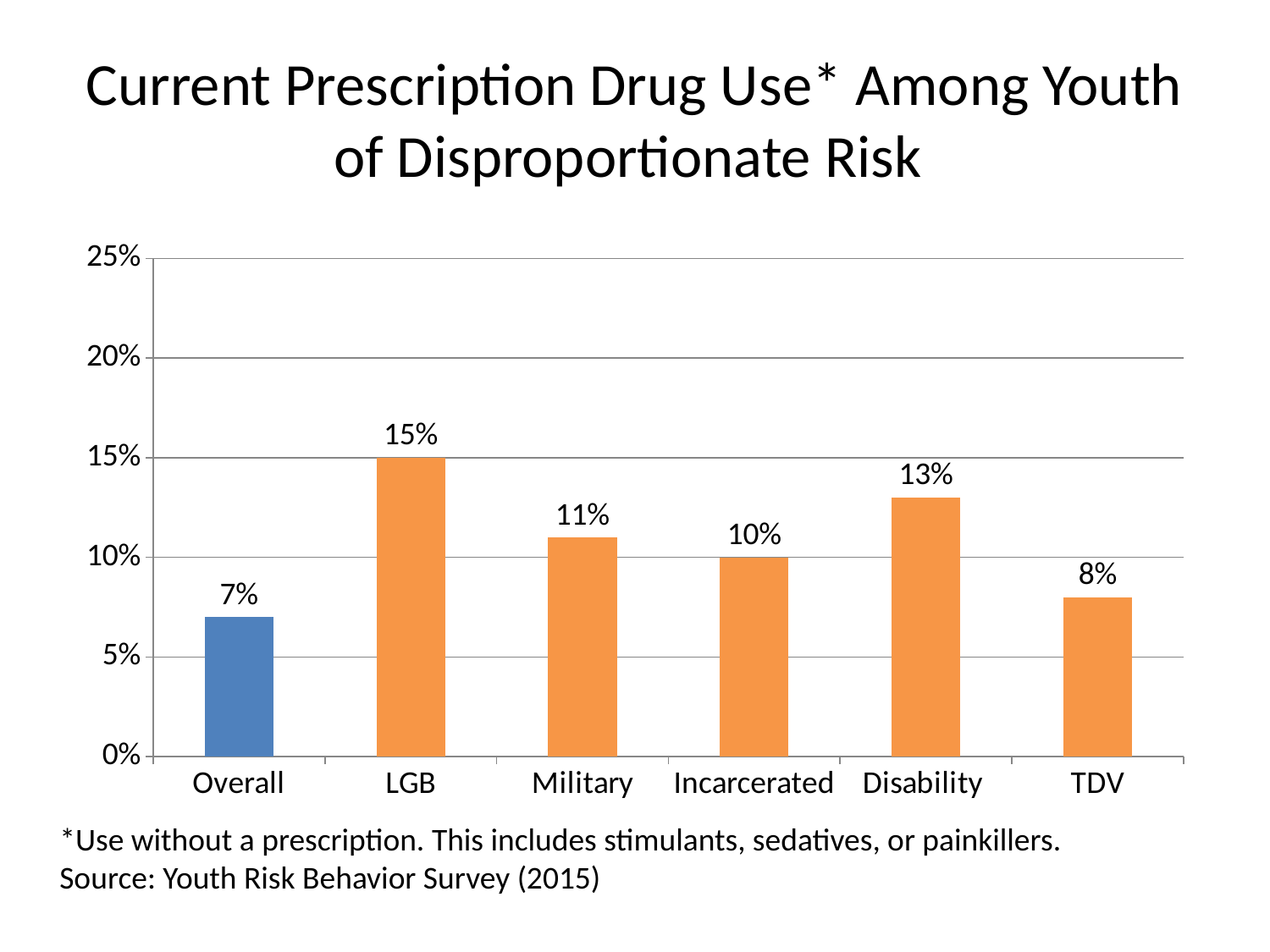
What is the value for LGB? 15% How many categories are shown on the x axis? 6 What kind of chart is shown on the slide? Bar chart Is the value for Disability greater or less than 10%? greater What is the value for Disability? 13% What is the value for Overall? 7% Which category has the highest value? LGB Which bar is coloured differently from the others? Overall What is the value for TDV? 8% Which is larger, the value for Military or the value for Incarcerated? Military What is the difference between the values for LGB and Overall? 8% Which category has the lowest value? Overall